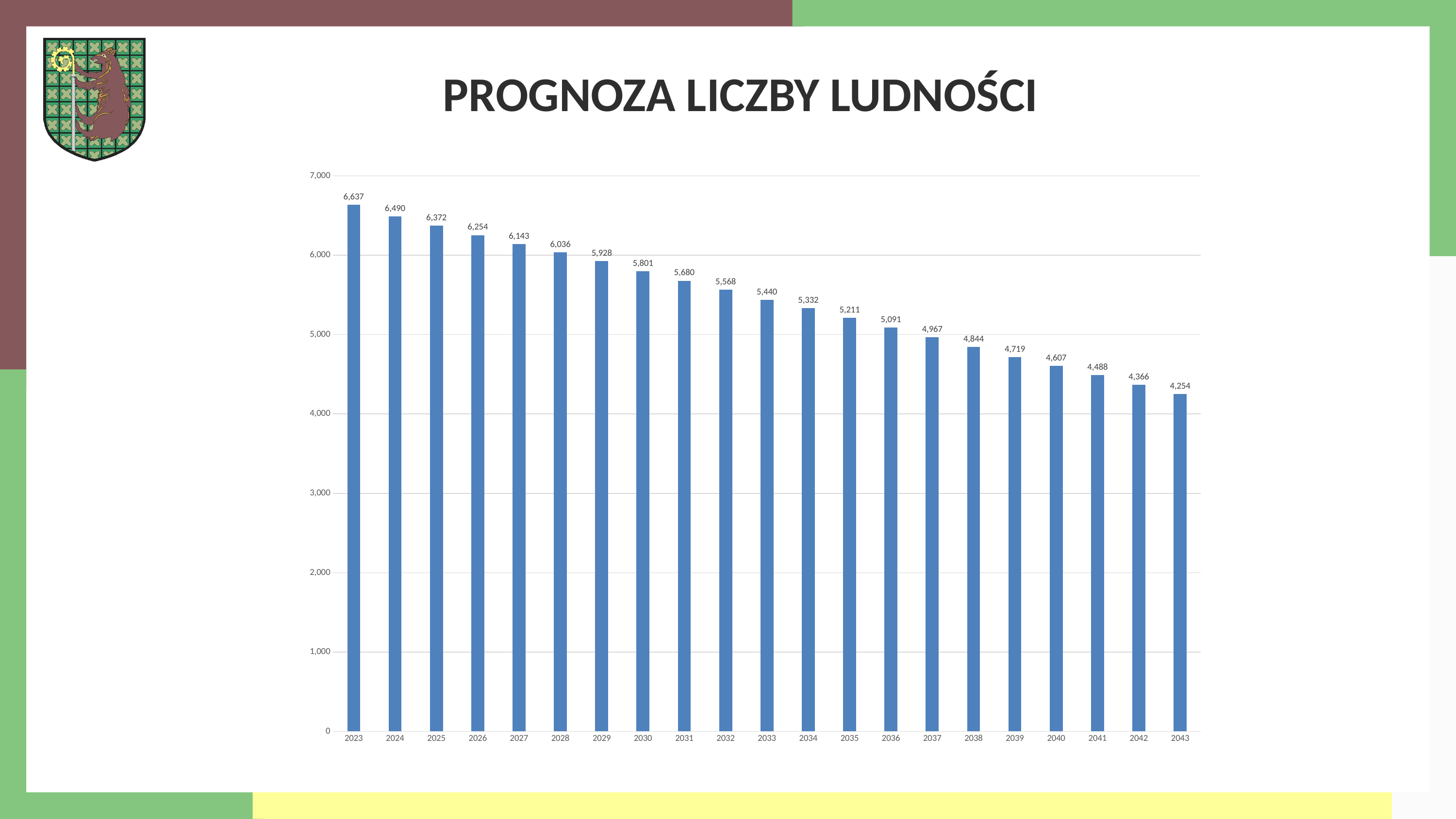
Do the projected population values rise or fall from 2023 to 2043? Fall What is the projected population value for 2043? 4,254 What is the projected population value for 2038? 4,844 What kind of chart is shown on the slide? Bar chart How many years (bars) are shown on the chart? 21 What is the difference between the projected population in 2030 and in 2031? 121 What is the projected population value for 2033? 5,440 What is the projected population value for 2023? 6,637 Which year has a larger projected population, 2027 or 2035? 2027 Which year has the highest projected population? 2023 What is the difference between the projected population in 2023 and in 2043? 2,383 Which year has the lowest projected population? 2043